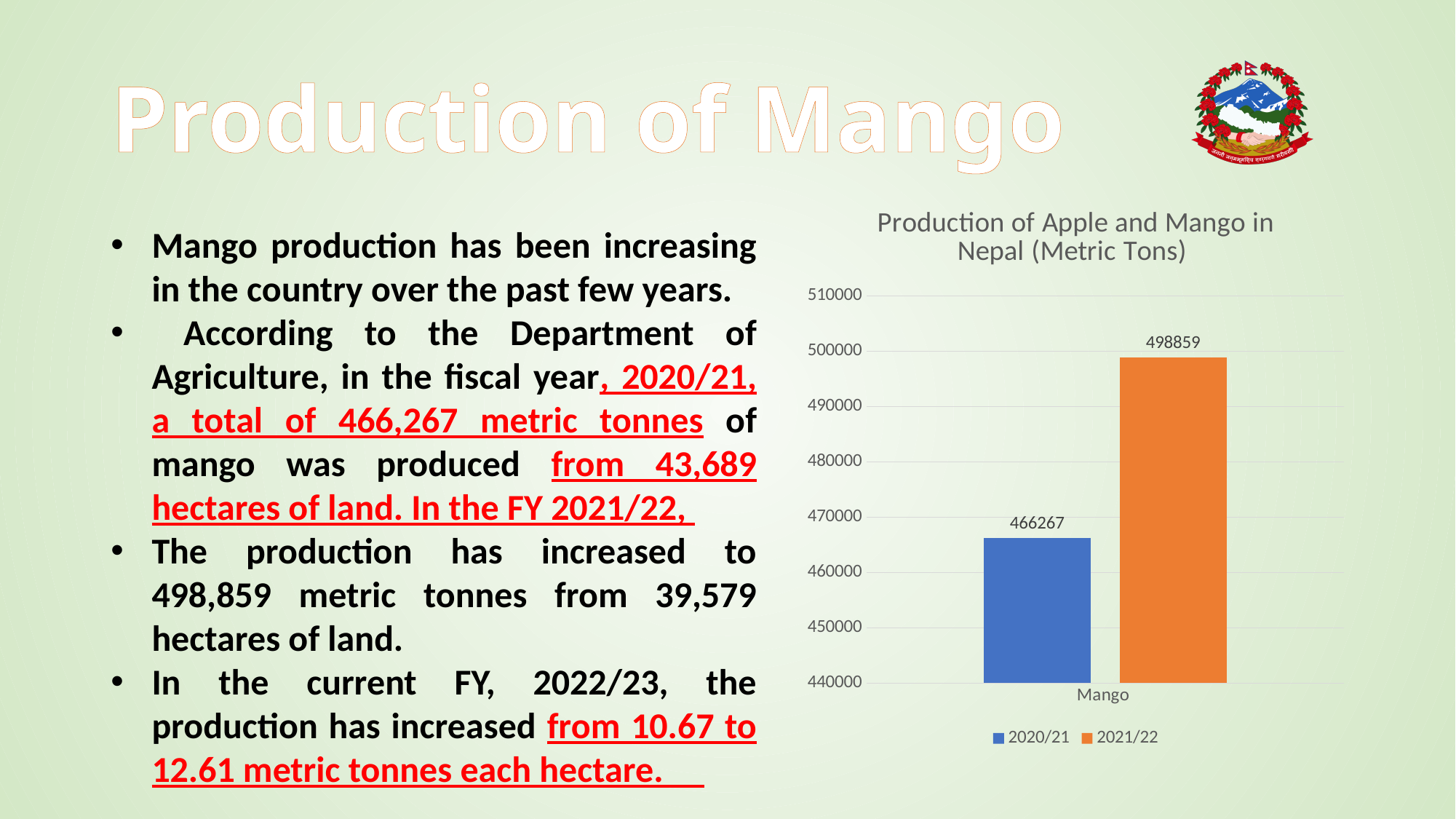
What is the difference between the 2021/22 and 2020/21 mango production values? 32592 Is the value for 2021/22 greater or less than 490000? greater What is the mango production value for 2021/22 in the chart? 498859 What is the mango production value for 2020/21 in the chart? 466267 What colour is the bar for the 2021/22 series? orange How many categories are shown on the x axis of the chart? 1 Is the value for 2020/21 greater or less than 470000? less How many series does the legend list? 2 Which series has the lowest value in the chart? 2020/21 What kind of chart is shown on the slide? bar chart Which series shows the higher mango production, 2020/21 or 2021/22? 2021/22 What is the title of the chart? Production of Apple and Mango in Nepal (Metric Tons)